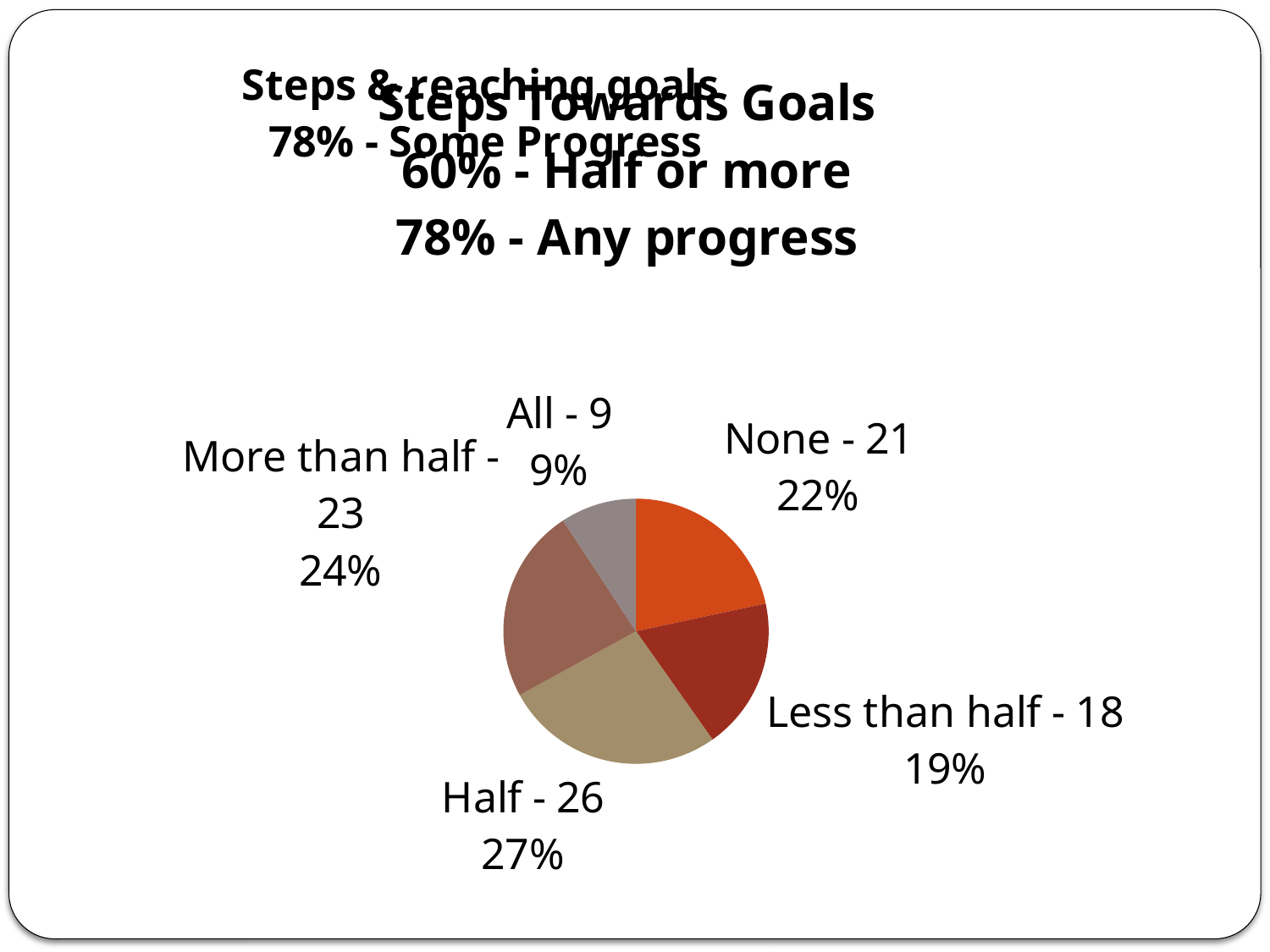
What is the count for the "Less than half" slice? 18 Which is larger, the count for "More than half" or the count for "None"? More than half What kind of chart is shown on the slide? pie chart What is the total of the counts across all slices of the pie chart? 97 What is the difference between the counts for "Half" and "All"? 17 What percentage share does the "None" slice have? 22% Which slice of the pie chart is the smallest? All Which slice of the pie chart is the largest? Half What percentage share does the "All" slice have? 9% How many slices does the pie chart have? 5 What is the count for the "Half" slice? 26 What percentage share does the "More than half" slice have? 24%